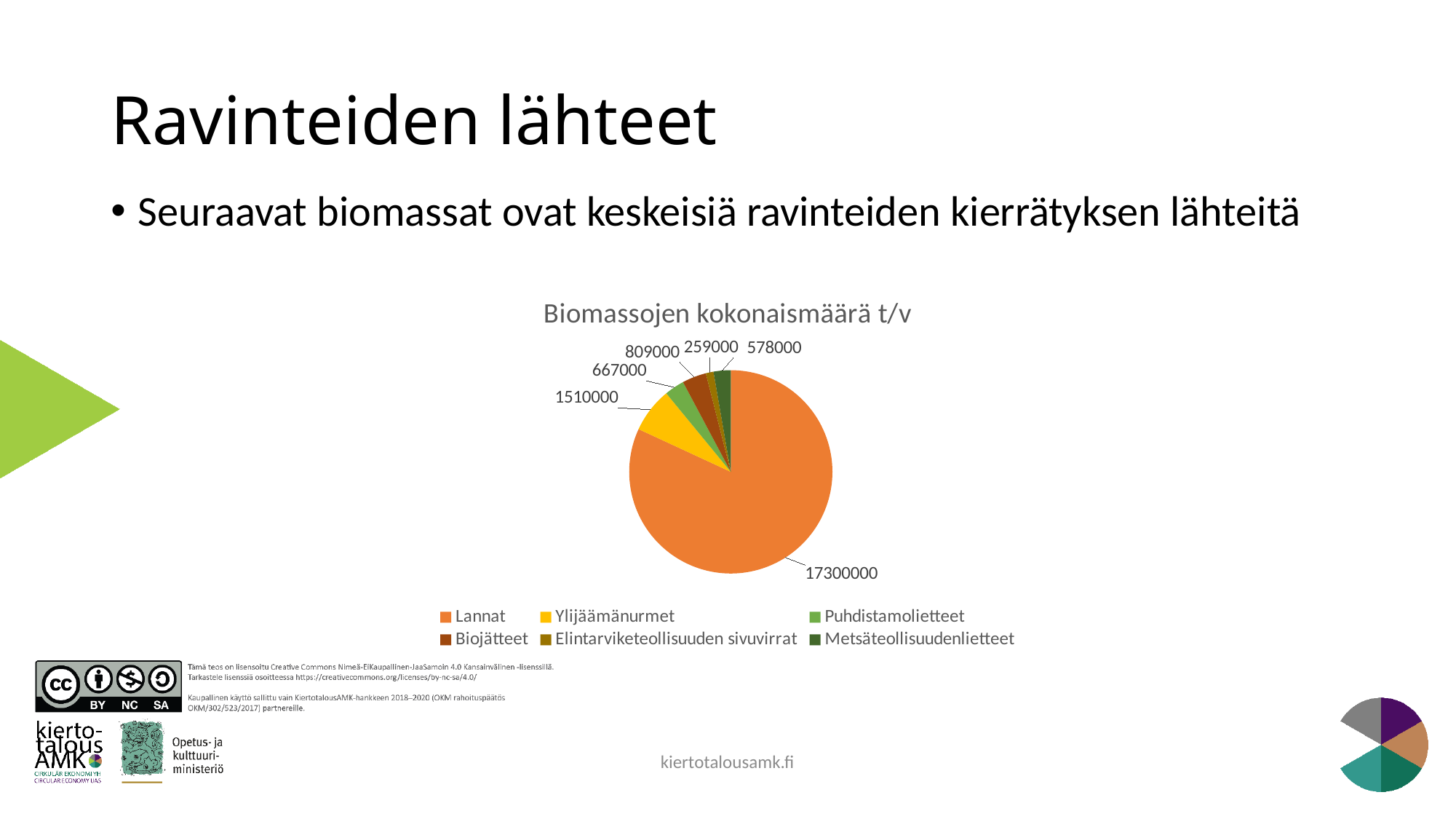
What is the value for Metsäteollisuudenlietteet in the pie chart? 578000 What is the value for Lannat in the pie chart? 17300000 What is the title of the chart? Biomassojen kokonaismäärä t/v How many categories does the pie chart show? 6 Which is larger, the value for Biojätteet or the value for Puhdistamolietteet? Biojätteet What is the value for Biojätteet in the pie chart? 809000 What is the difference between the values for Ylijäämänurmet and Puhdistamolietteet? 843000 Which category has the largest slice in the pie chart? Lannat What type of chart is shown on the slide? Pie chart What is the value for Elintarviketeollisuuden sivuvirrat in the pie chart? 259000 Which category has the smallest slice in the pie chart? Elintarviketeollisuuden sivuvirrat What is the value for Ylijäämänurmet in the pie chart? 1510000